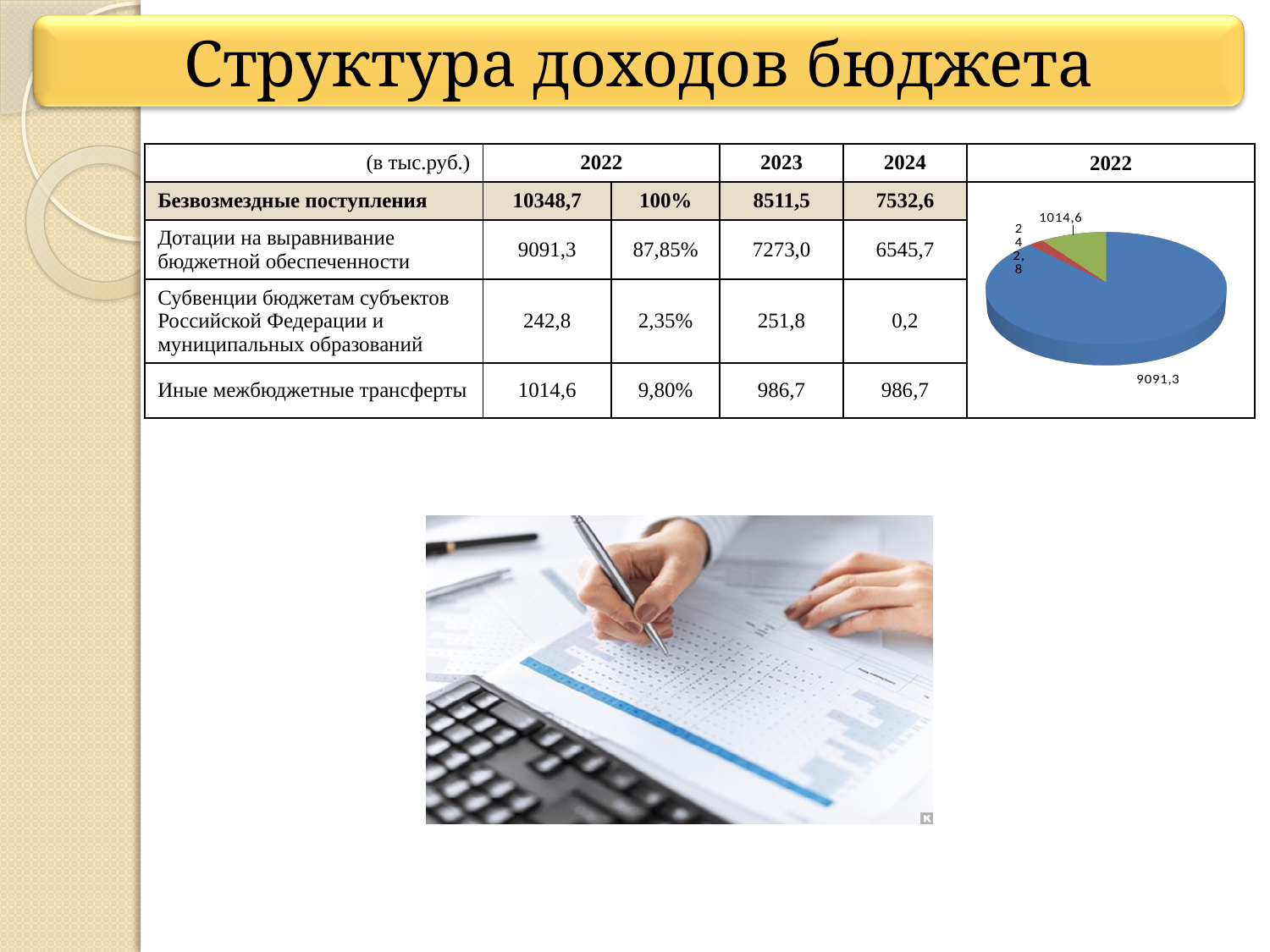
What is the difference between the slice labelled 9091,3 and the slice labelled 1014,6 in the pie chart? 8076,7 How many slices does the pie chart have? 3 What colour is the largest slice of the pie chart? blue What is the total of all three slices in the pie chart? 10348,7 What kind of chart is shown on the slide? pie chart Which slice is larger in the pie chart: the one labelled 1014,6 or the one labelled 242,8? 1014,6 What share of the pie does the slice labelled 9091,3 represent, according to the table? 87,85% What is the value of the largest slice of the pie chart? 9091,3 What is the value of the smallest slice of the pie chart? 242,8 What value is labelled on the green slice of the pie chart? 1014,6 What value is labelled on the red slice of the pie chart? 242,8